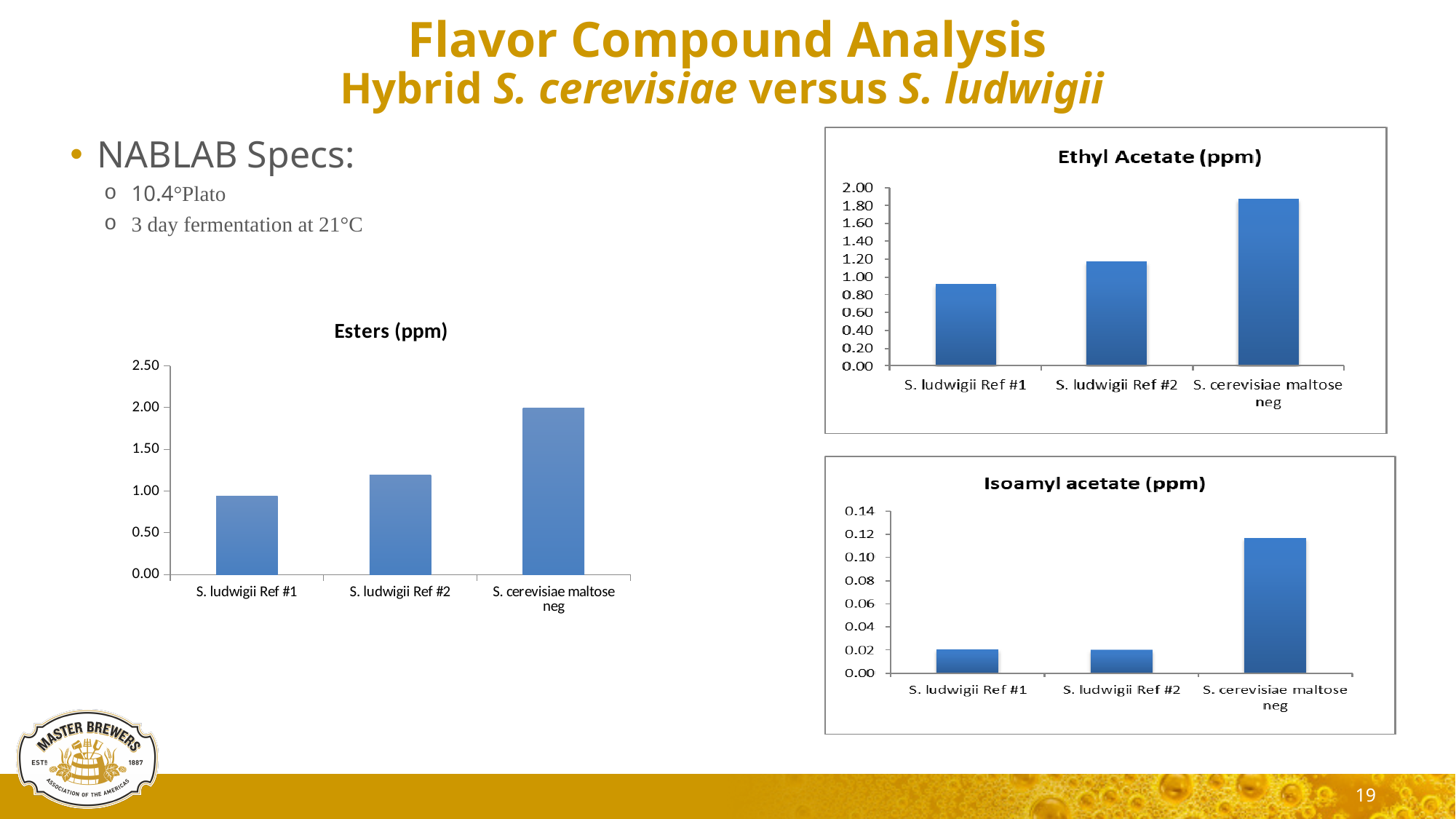
In the Isoamyl acetate (ppm) chart, is the value for S. cerevisiae maltose neg greater or less than 0.10? greater What kind of chart is the Esters (ppm) chart? bar chart In the Ethyl Acetate (ppm) chart, which category has the highest value? S. cerevisiae maltose neg In the Ethyl Acetate (ppm) chart, which is larger, S. ludwigii Ref #1 or S. ludwigii Ref #2? S. ludwigii Ref #2 In the Ethyl Acetate (ppm) chart, do the values rise or fall from left to right across the categories? rise How many categories are shown in the Isoamyl acetate (ppm) chart? 3 In the Ethyl Acetate (ppm) chart, is the value for S. cerevisiae maltose neg greater or less than 1.80? greater In the Esters (ppm) chart, is the value for S. ludwigii Ref #2 greater or less than 1.00? greater In the Esters (ppm) chart, which category has the highest value? S. cerevisiae maltose neg In the Isoamyl acetate (ppm) chart, which category has the highest value? S. cerevisiae maltose neg In the Esters (ppm) chart, which category has the lowest value? S. ludwigii Ref #1